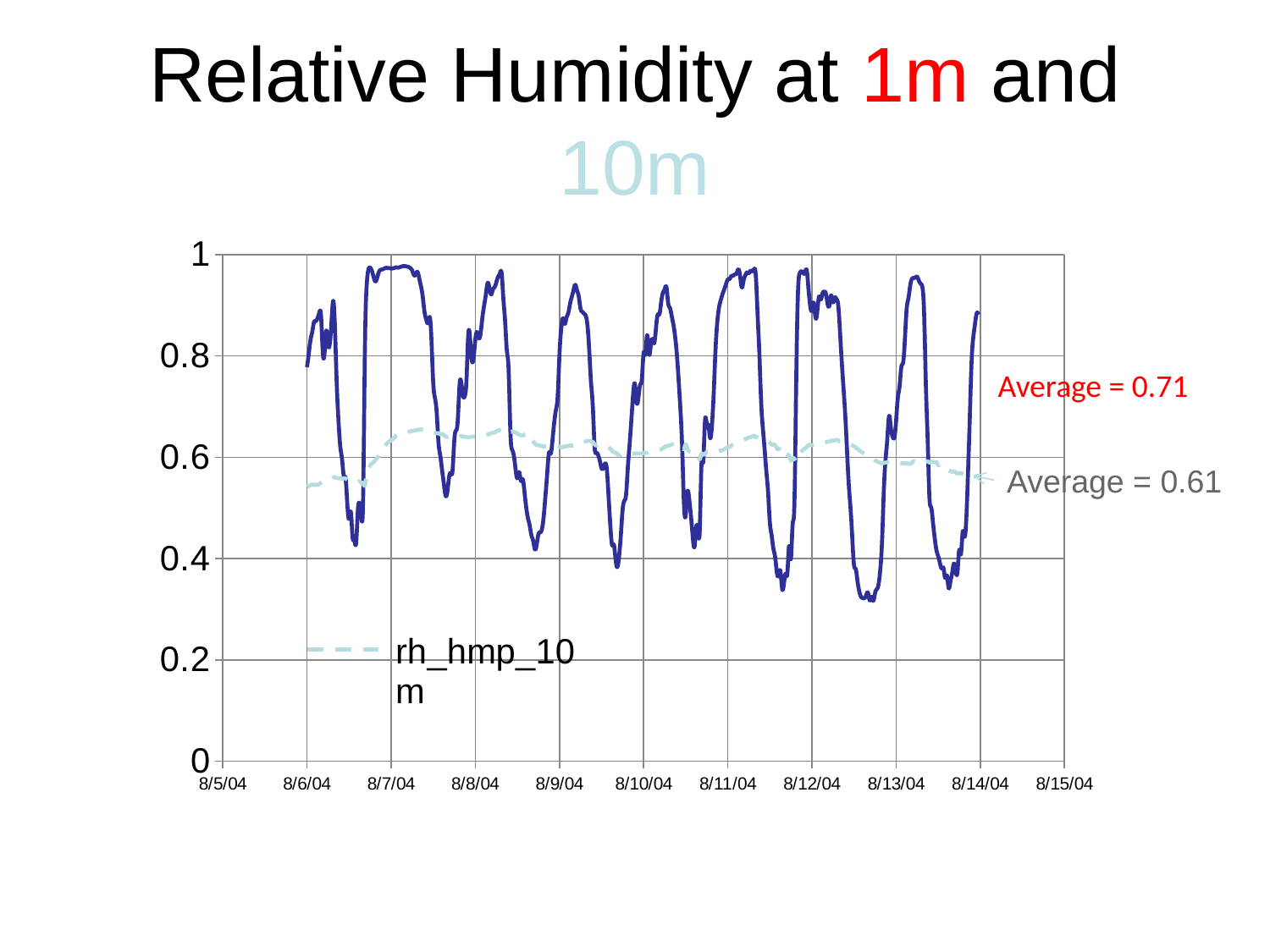
What kind of chart is shown on the slide? line chart Is the lowest value reached by the solid dark blue line greater or less than 0.4? less What is the last date label on the x axis? 8/15/04 What average value is annotated in grey next to the dashed line? 0.61 What average value is annotated in red on the chart? 0.71 Is the highest value reached by the dashed line greater or less than 0.8? less What is the difference between the two annotated averages, 0.71 and 0.61? 0.10 What is the first date label on the x axis? 8/5/04 How many date labels are shown along the x axis? 11 Which annotated average is larger, the red one or the grey one? the red one (0.71) What series name appears in the chart's legend? rh_hmp_10m What is the title of the slide's chart? Relative Humidity at 1m and 10m